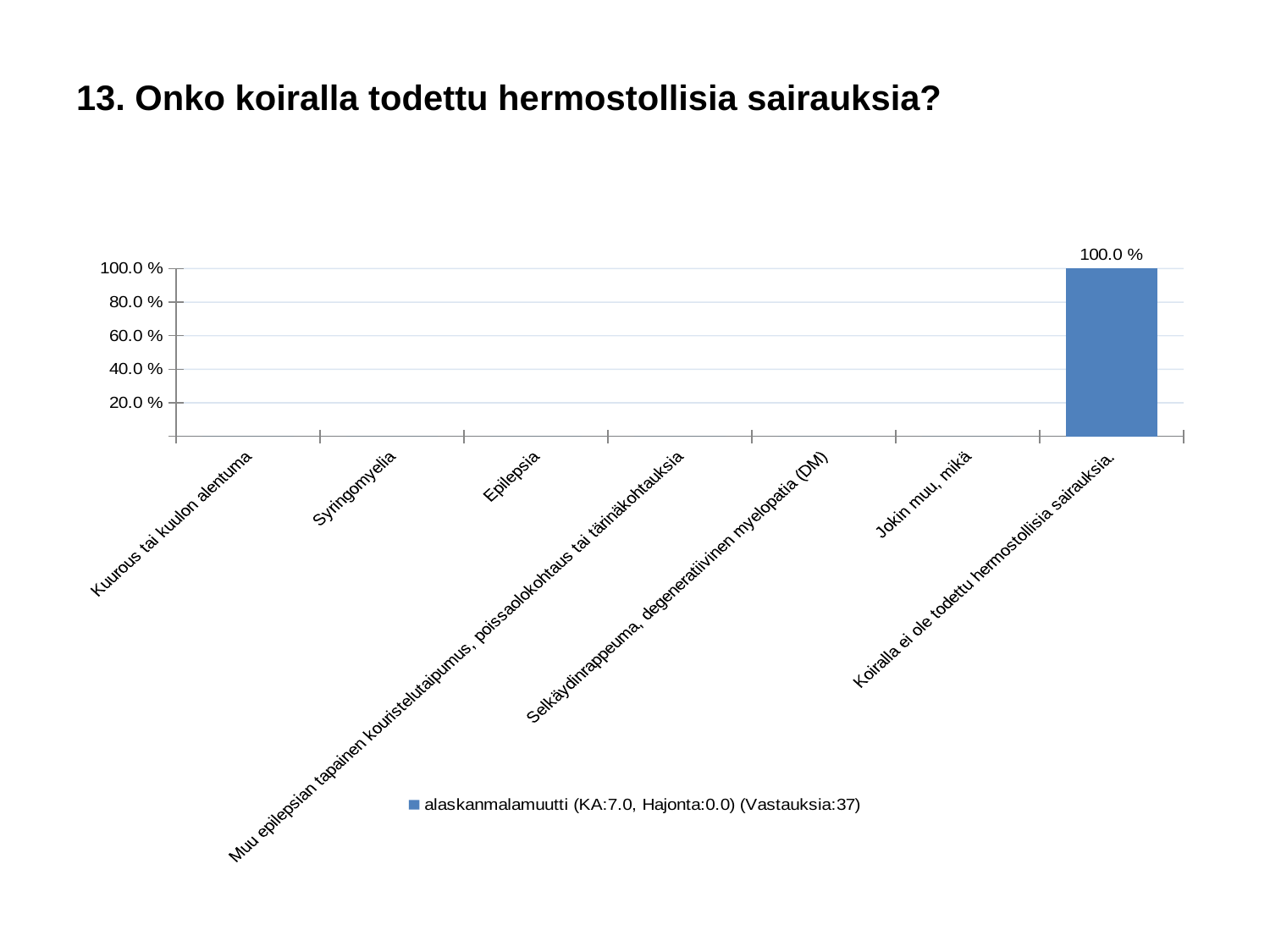
Which is larger: the value for "Jokin muu, mikä" or the value for "Koiralla ei ole todettu hermostollisia sairauksia."? Koiralla ei ole todettu hermostollisia sairauksia. Is the value for "Koiralla ei ole todettu hermostollisia sairauksia." greater or less than 80.0 %? greater How many series does the legend list? 1 What is the highest tick value shown on the y axis? 100.0 % What is the title of the slide? 13. Onko koiralla todettu hermostollisia sairauksia? What is the legend entry for the series? alaskanmalamuutti (KA:7.0, Hajonta:0.0) (Vastauksia:37) What kind of chart is shown on the slide? bar chart Which category has the highest value? Koiralla ei ole todettu hermostollisia sairauksia. Is the value for Syringomyelia greater or less than 20.0 %? less Is the value for Epilepsia greater or less than 20.0 %? less What is the value for "Koiralla ei ole todettu hermostollisia sairauksia."? 100.0 % How many categories are shown on the x axis? 7